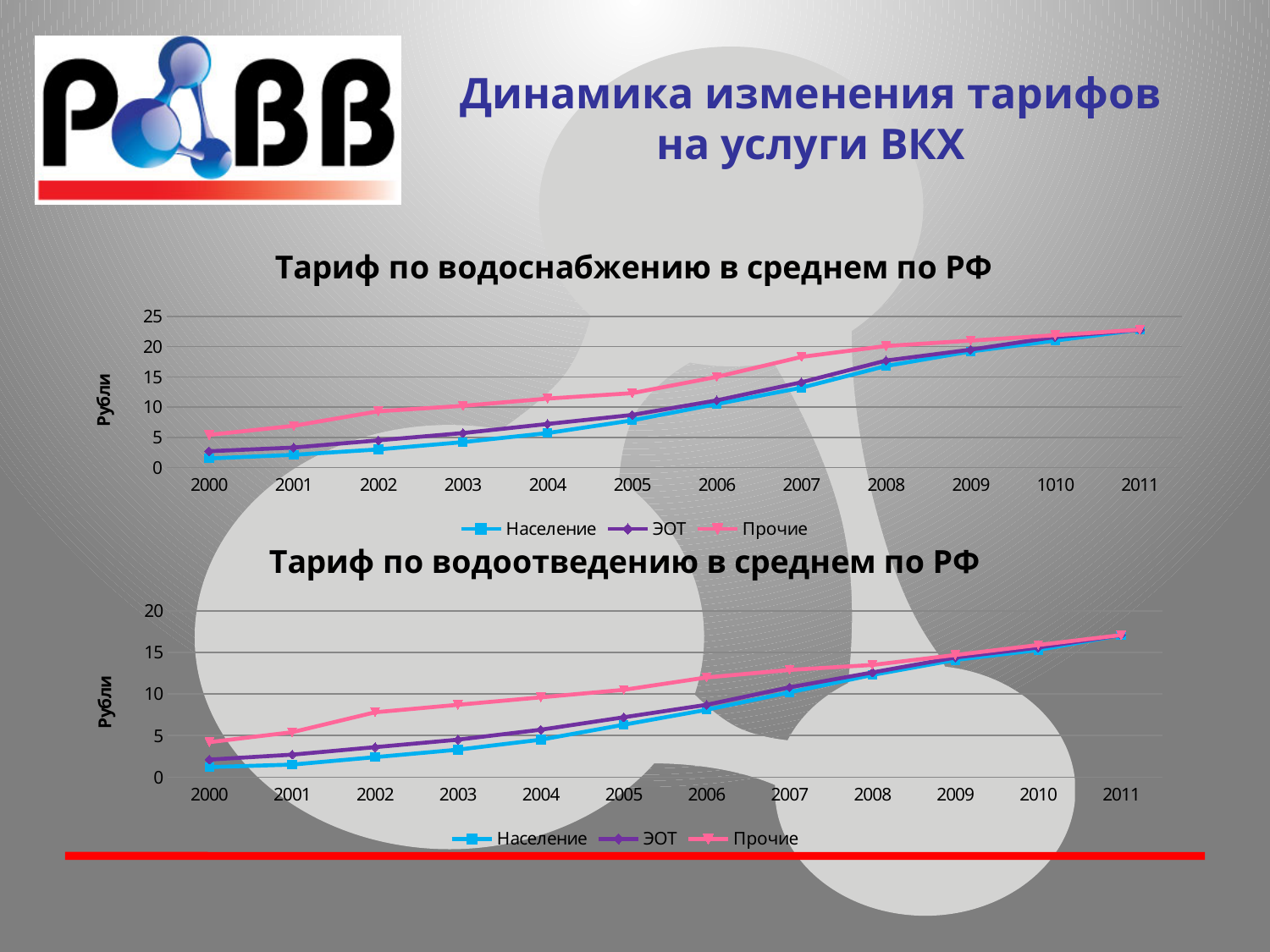
In the bottom chart 'Тариф по водоотведению в среднем по РФ', is the value for Прочие in 2006 greater or less than 10? greater What is the label on the vertical axis of the bottom chart 'Тариф по водоотведению в среднем по РФ'? Рубли In the top chart 'Тариф по водоснабжению в среднем по РФ', is the value for Население in 2000 greater or less than 5? less In the top chart 'Тариф по водоснабжению в среднем по РФ', which series has the lowest value in 2000? Население How many series does the legend of the top chart 'Тариф по водоснабжению в среднем по РФ' list? 3 In the bottom chart 'Тариф по водоотведению в среднем по РФ', which is larger in 2005: the value for Прочие or the value for Население? Прочие In the bottom chart 'Тариф по водоотведению в среднем по РФ', is the value for ЭОТ in 2011 greater or less than 15? greater In the top chart 'Тариф по водоснабжению в среднем по РФ', which series has the highest value in 2000? Прочие In the top chart 'Тариф по водоснабжению в среднем по РФ', do the values for Население rise or fall from 2000 to 2011? rise How many years are plotted along the x axis of the bottom chart 'Тариф по водоотведению в среднем по РФ'? 12 What kind of chart is the top chart, 'Тариф по водоснабжению в среднем по РФ'? line chart